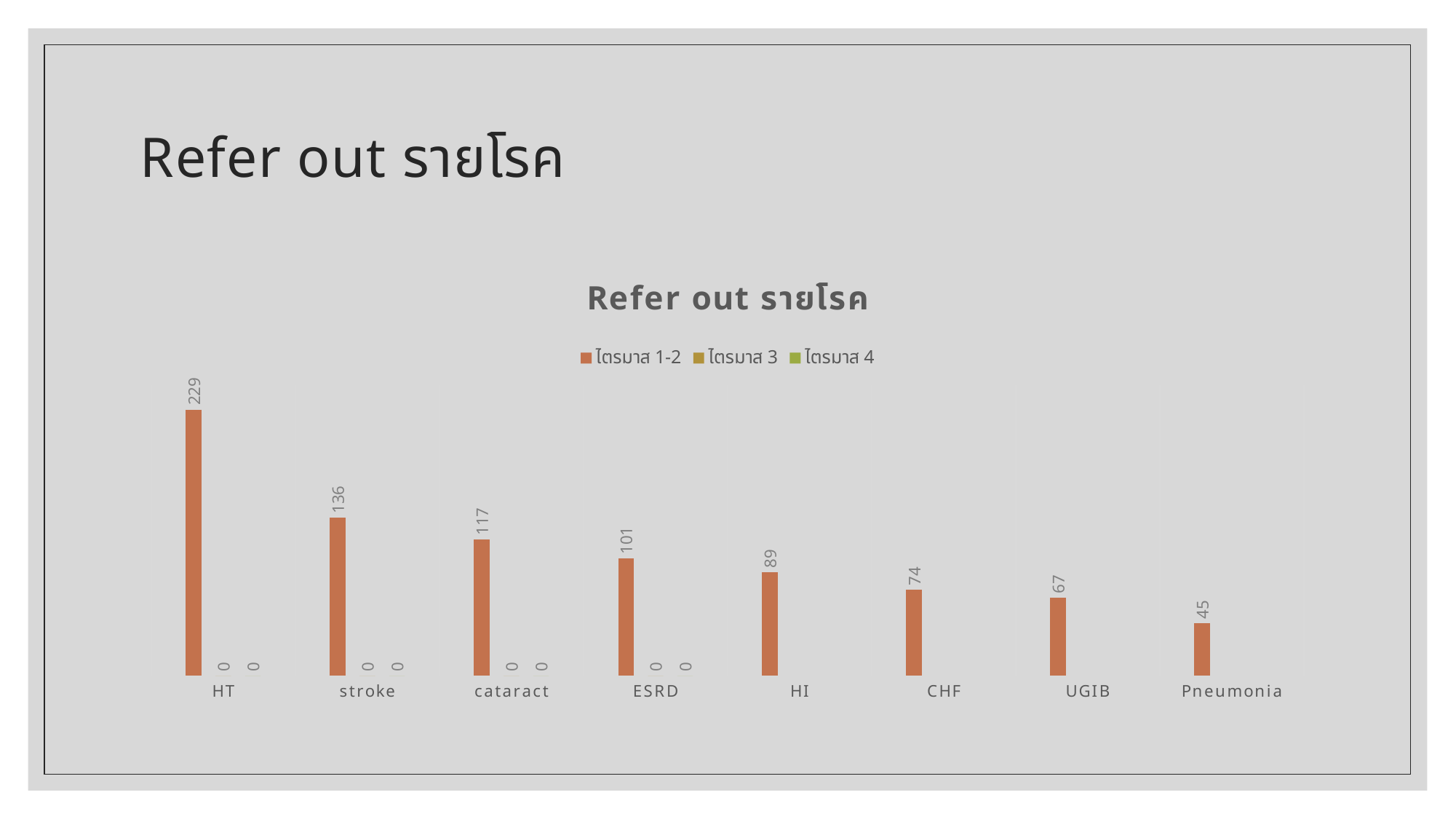
What is the value for HT in the ไตรมาส 1-2 series? 229 What kind of chart is shown? bar chart What is the value for stroke in the ไตรมาส 1-2 series? 136 Which category has the highest ไตรมาส 1-2 value? HT What is the value for ESRD in the ไตรมาส 3 series? 0 What is the value for Pneumonia in the ไตรมาส 1-2 series? 45 What is the title of the chart? Refer out รายโรค Which has a larger ไตรมาส 1-2 value, cataract or HI? cataract Which category has the lowest ไตรมาส 1-2 value? Pneumonia What is the difference between the ไตรมาส 1-2 values for HT and stroke? 93 How many categories are shown on the x axis? 8 How many series does the legend list? 3